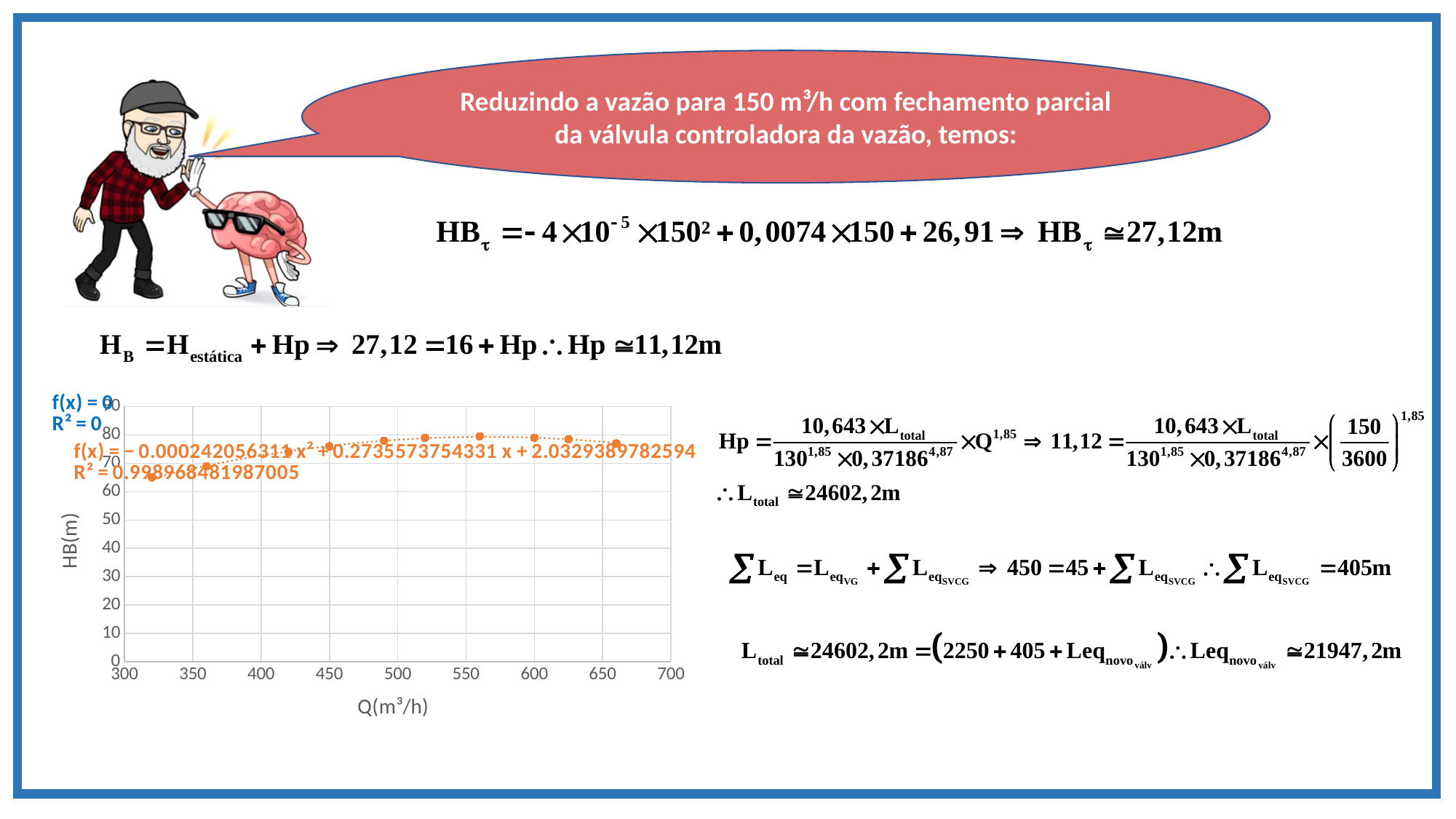
How many data points are plotted on the chart? 10 Which point has the lower HB value: the one at Q = 320 m³/h or the one at Q = 560 m³/h? Q = 320 m³/h What is the title of the x axis of the chart? Q(m³/h) Is the HB value for the point at Q = 320 m³/h greater or less than 60? greater Do the HB values rise or fall as Q increases from 300 to 500 m³/h? rise Is the HB value for the point at Q = 320 m³/h greater or less than 70? less Is the HB value for the point at Q = 660 m³/h greater or less than 80? less What is the highest value shown on the y axis of the chart? 90 What R² value is printed for the orange trendline on the chart? 0.998968481987005 What kind of chart is shown on the slide? scatter chart What is the title of the y axis of the chart? HB(m)